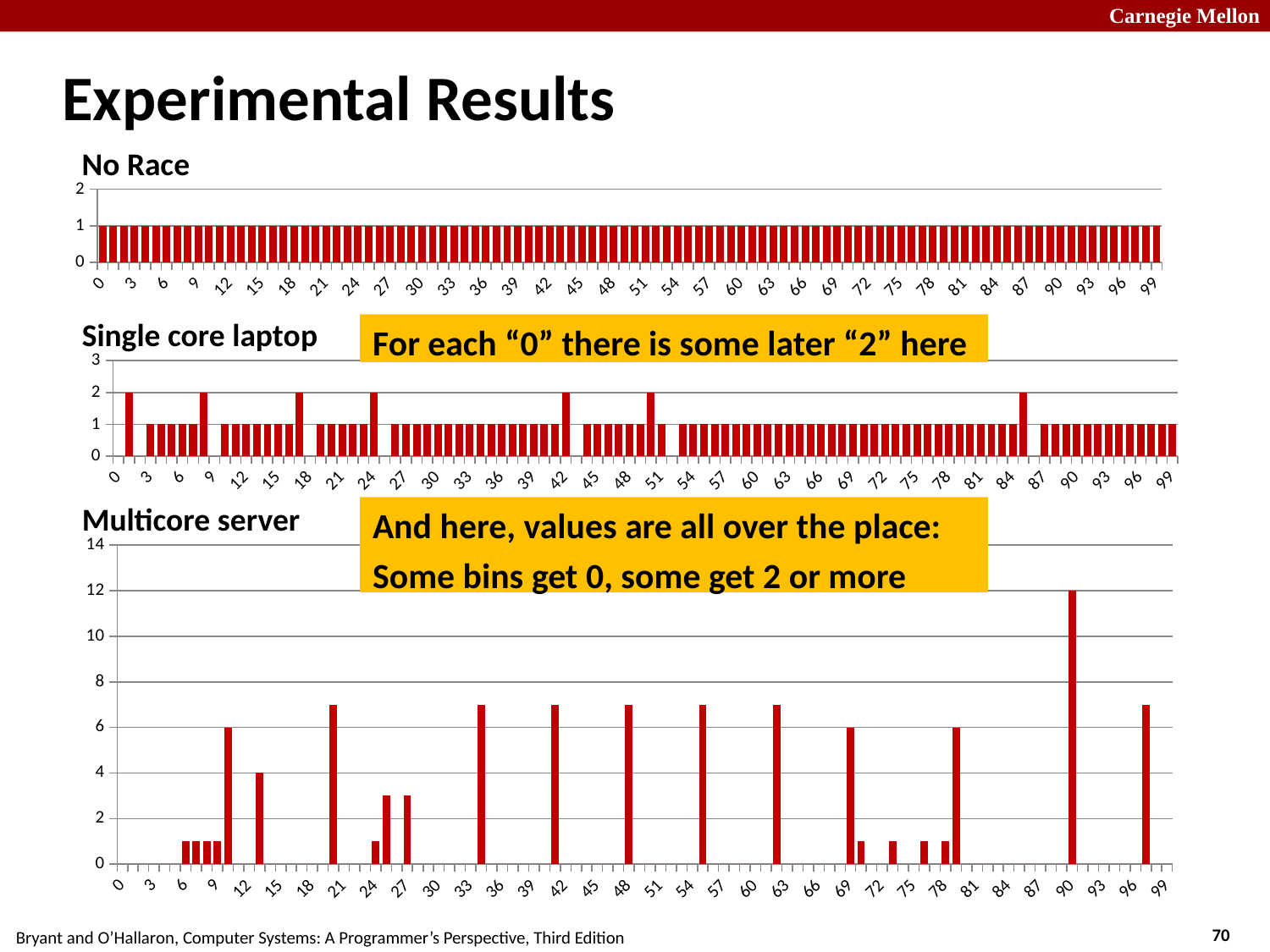
In the "No Race" chart, is the value for category 50 greater or less than 2? less In the "Multicore server" chart, what is the difference between the values for category 90 and category 10? 6 In the "Single core laptop" chart, is the value for category 30 greater or less than 2? less What kind of chart is the "No Race" chart at the top of the slide? bar chart In the "Single core laptop" chart, what is the value for category 1? 2 In the "Multicore server" chart, is the value for category 20 greater or less than 6? greater In the "Single core laptop" chart, what is the value for category 42? 2 How many charts are shown on the slide? 3 In the "Multicore server" chart, what is the value for category 10? 6 In the "Multicore server" chart, which category has the highest value? 90 In the "No Race" chart, what is the value for category 0? 1 In the "Multicore server" chart, what is the value for category 90? 12